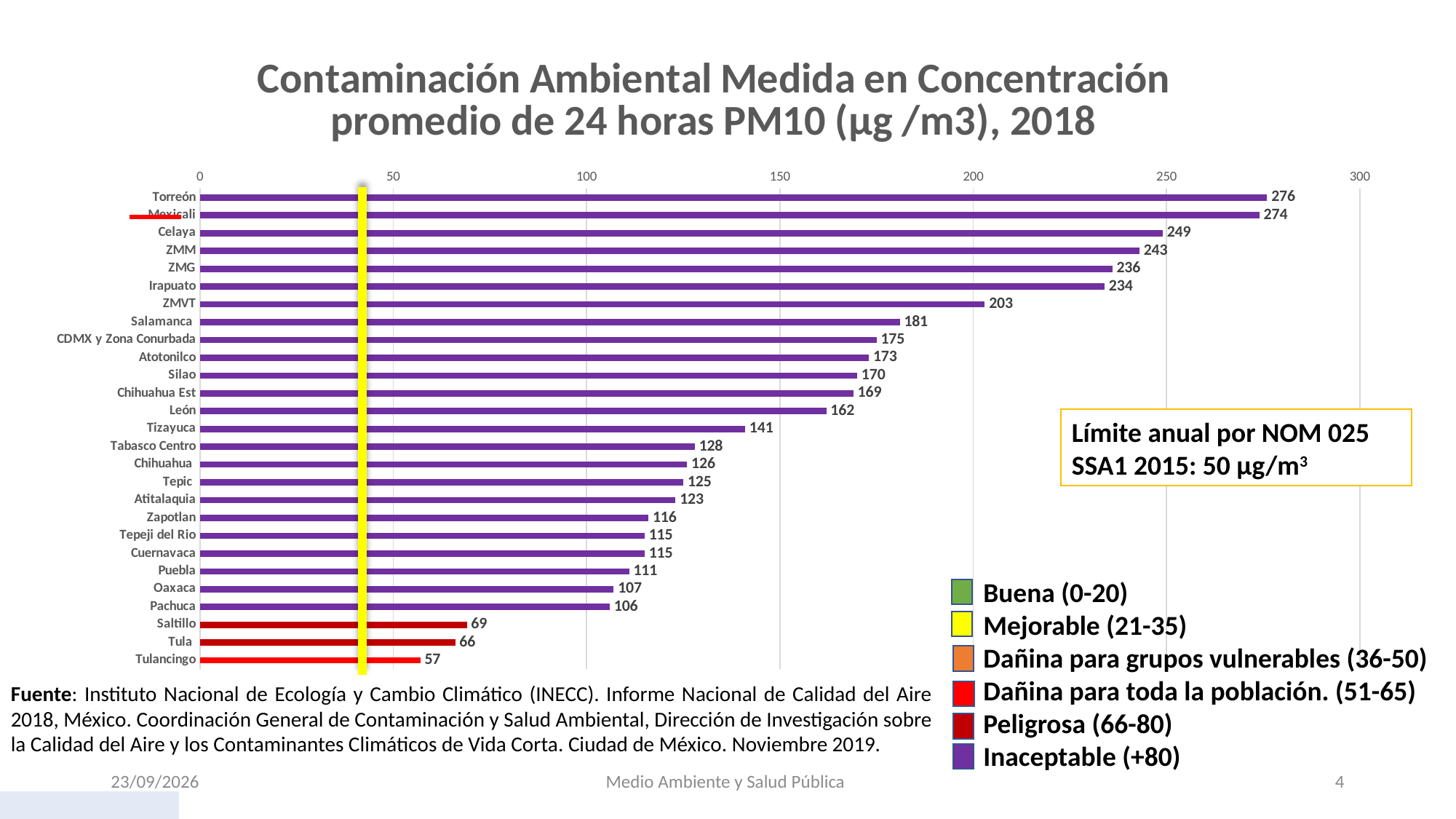
What kind of chart is shown on the slide? Bar chart What is the difference between the PM10 values for Celaya and ZMVT? 46 Which has a higher PM10 value, Salamanca or León? Salamanca What is the PM10 value for Torreón? 276 Which city has the lowest PM10 value? Tulancingo Is the value for Pachuca greater or less than 100? greater What is the PM10 value for Tulancingo? 57 How many cities are shown in the chart? 27 Which colour in the legend represents the 'Peligrosa (66-80)' category? Dark red Which city has the highest PM10 value? Torreón What is the PM10 value for CDMX y Zona Conurbada? 175 What is the annual limit stated in the box on the slide? 50 µg/m³